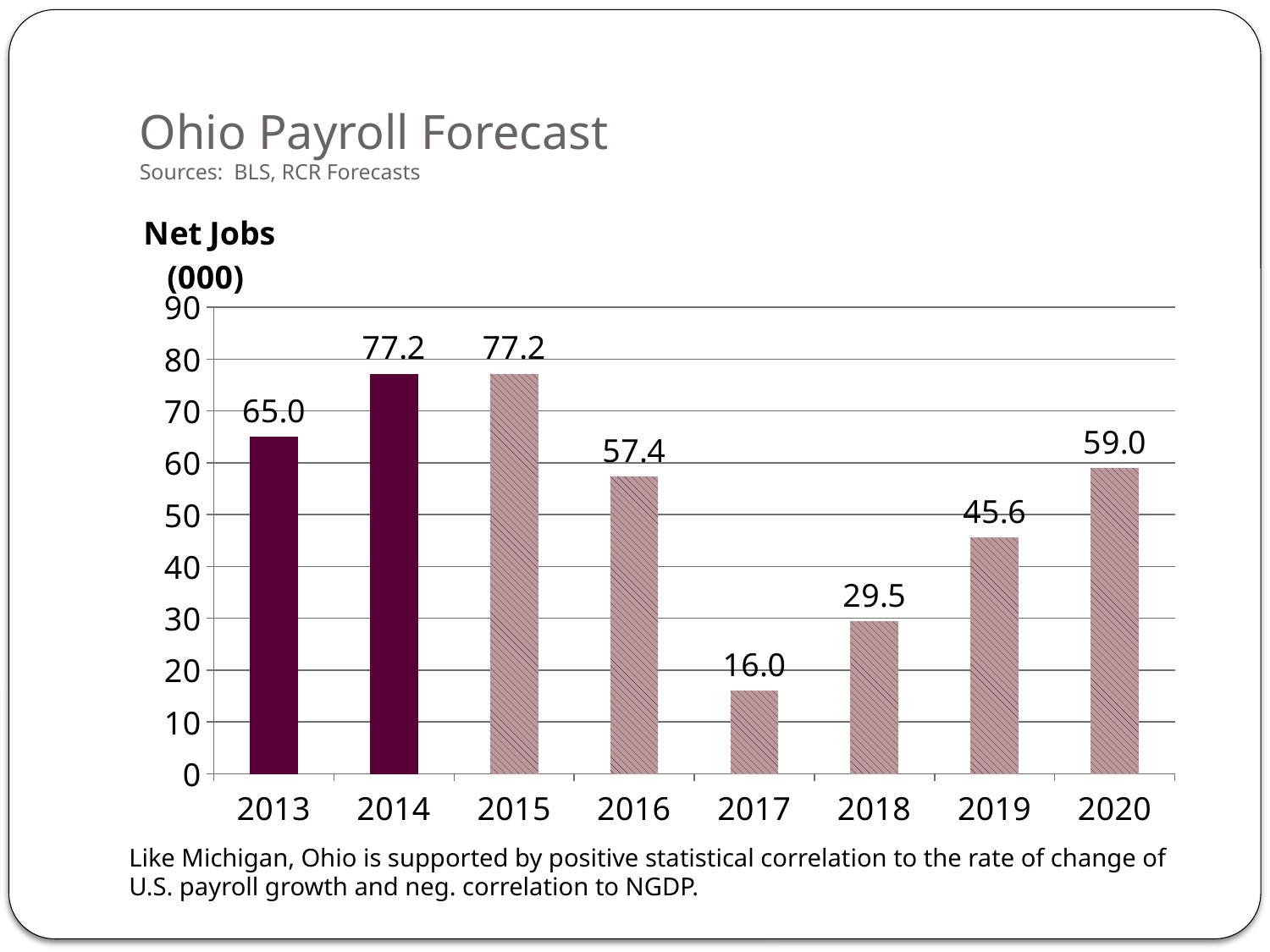
What is the value for 2017? 16.0 What is the title of the slide? Ohio Payroll Forecast What is the value for 2019? 45.6 Is the value for 2018 greater or less than 30? less Which is larger, the value for 2016 or the value for 2020? 2020 Do the values rise or fall from 2014 to 2017? fall What is the difference between the values for 2020 and 2018? 29.5 Which year has the lowest value? 2017 What kind of chart is shown? bar chart What is the value for 2013? 65.0 How many years are shown on the x axis? 8 What is the difference between the values for 2016 and 2017? 41.4